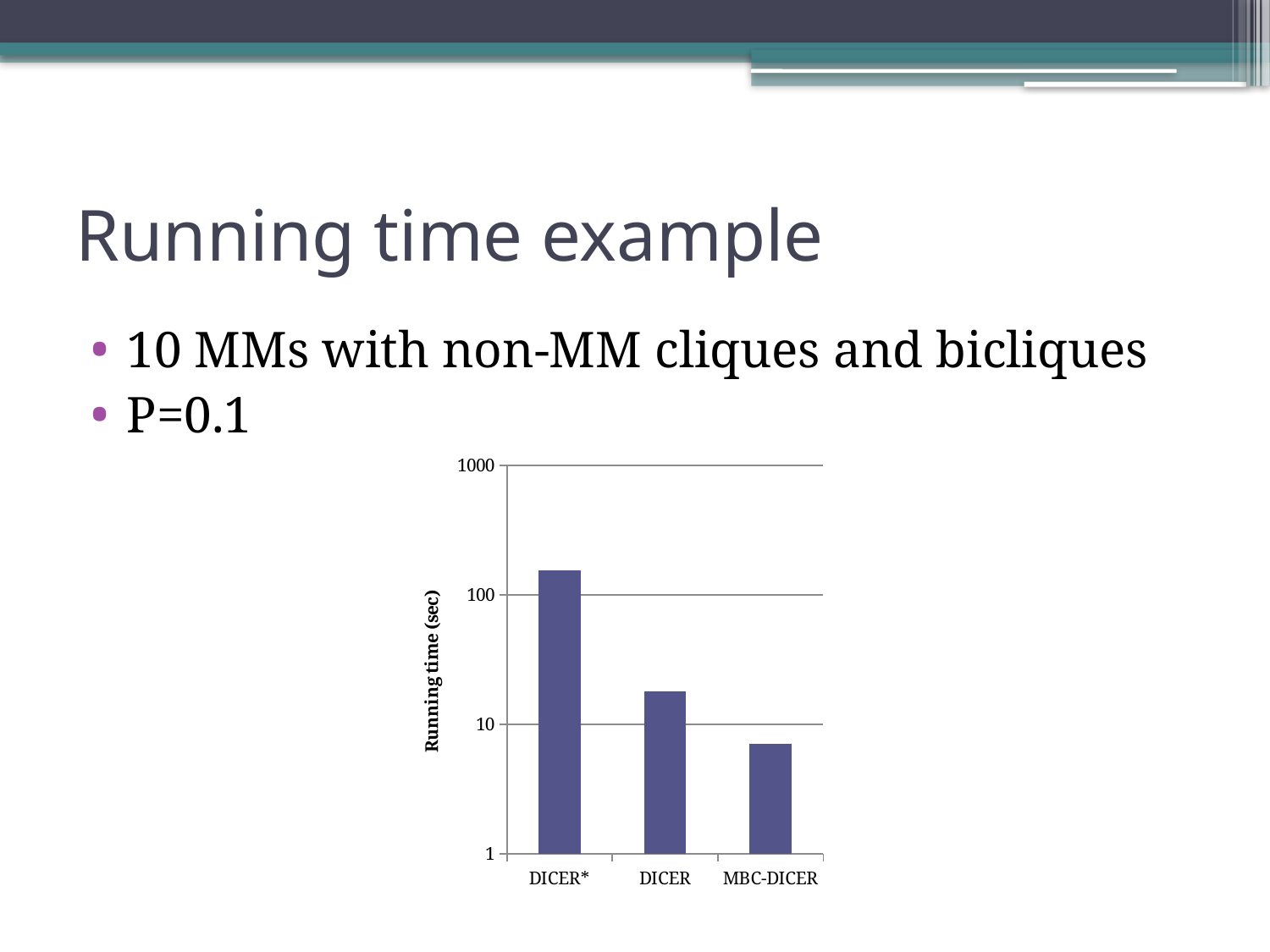
Is the value for DICER greater or less than 10? greater Which category has the lowest running time? MBC-DICER Is the value for DICER greater or less than 100? less Which has a larger running time, DICER or MBC-DICER? DICER What kind of chart is shown on the slide? bar chart Which has a larger running time, DICER* or DICER? DICER* Which category has the highest running time? DICER* Is the value for DICER* greater or less than 100? greater Do the bar values rise or fall from left to right across the categories? fall What is the label on the vertical axis of the chart? Running time (sec) How many categories are plotted on the chart? 3